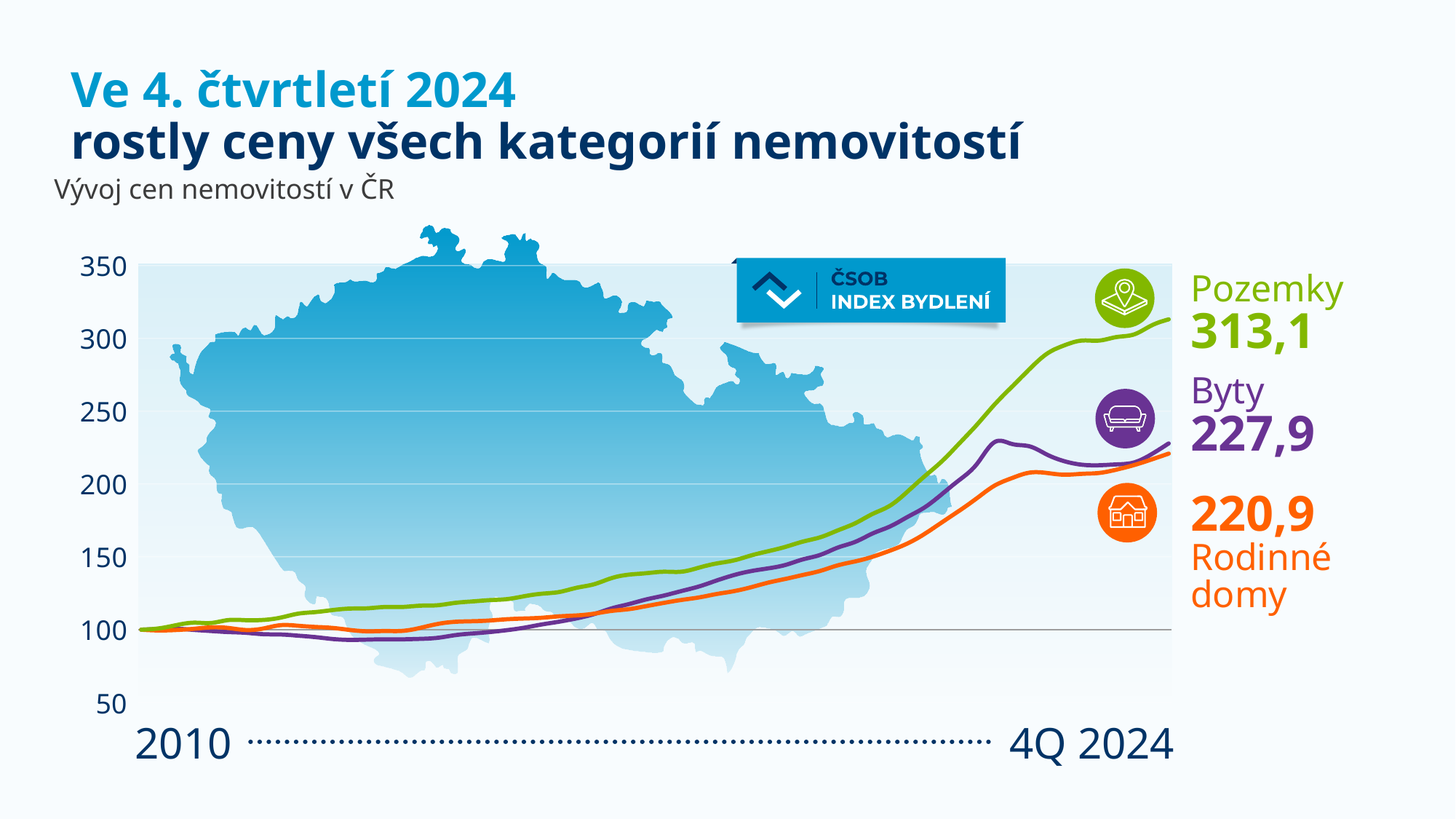
Do the values for Pozemky rise or fall from 2010 to 4Q 2024? rise Is the value for Pozemky at 4Q 2024 greater or less than 300? greater What is the difference between the 4Q 2024 values for Byty and Rodinné domy? 7,0 What is the value for Pozemky at 4Q 2024? 313,1 What is the value for Byty at 4Q 2024? 227,9 Which category has the lowest value at 4Q 2024? Rodinné domy What kind of chart is shown on the slide? line chart Which is larger at 4Q 2024, Pozemky or Rodinné domy? Pozemky Which category has the highest value at 4Q 2024? Pozemky How many series are plotted on the chart? 3 What is the difference between the 4Q 2024 values for Pozemky and Byty? 85,2 What is the value for Rodinné domy at 4Q 2024? 220,9